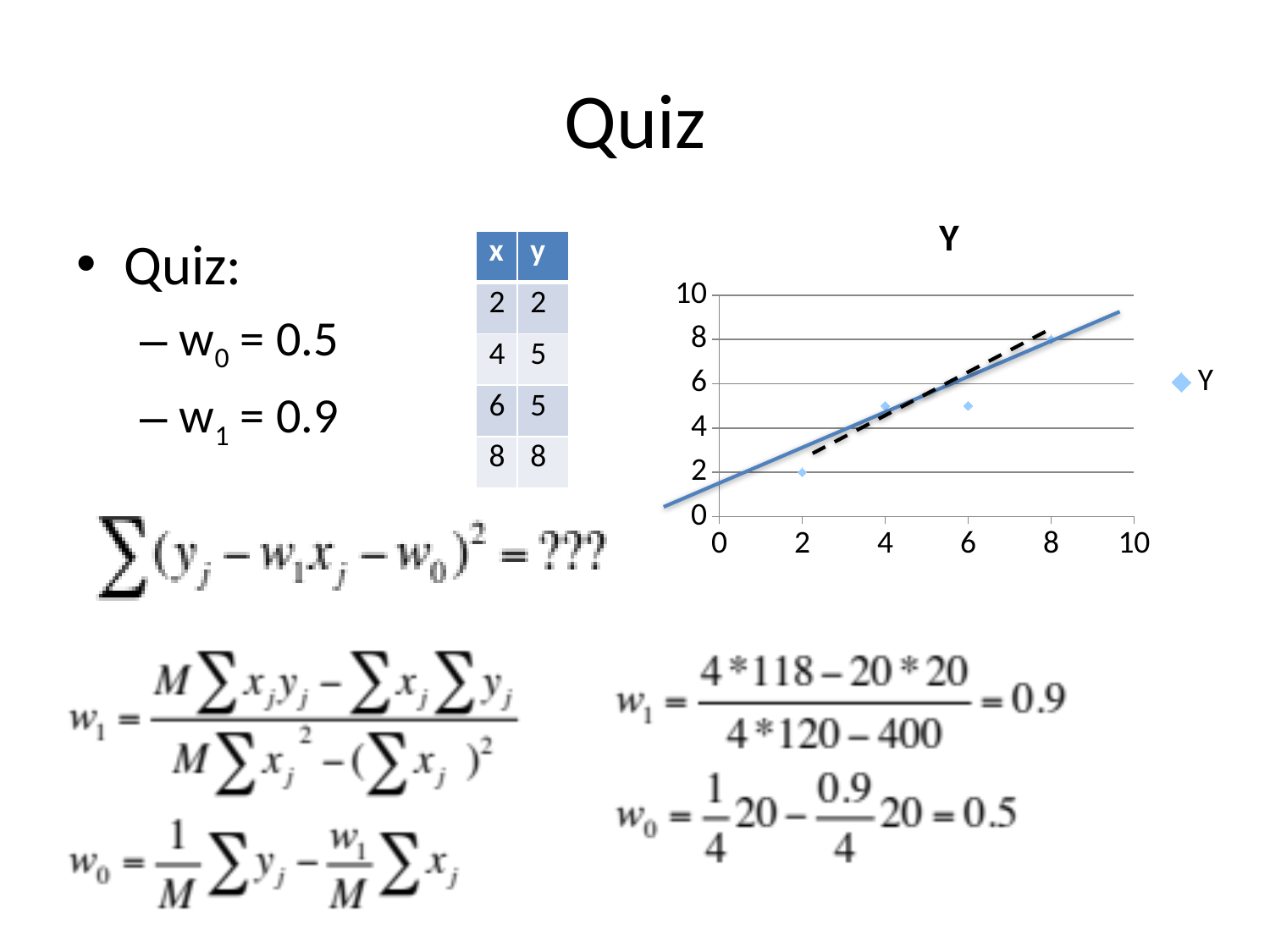
What is the title of the chart? Y At which x value is the highest Y point plotted? 8 What kind of chart is shown on the slide? scatter chart Is the Y value of the point at x = 6 greater or less than 6? less At which x value is the lowest Y point plotted? 2 Is the Y value of the point at x = 4 greater or less than 4? greater How many series does the chart legend list? 1 Do the Y values generally rise or fall as x increases? rise How many data points are plotted in the chart? 4 What is the difference between the Y value at x = 8 and the Y value at x = 2? 6 What is the Y value of the point at x = 2? 2 What is the Y value of the point at x = 8? 8